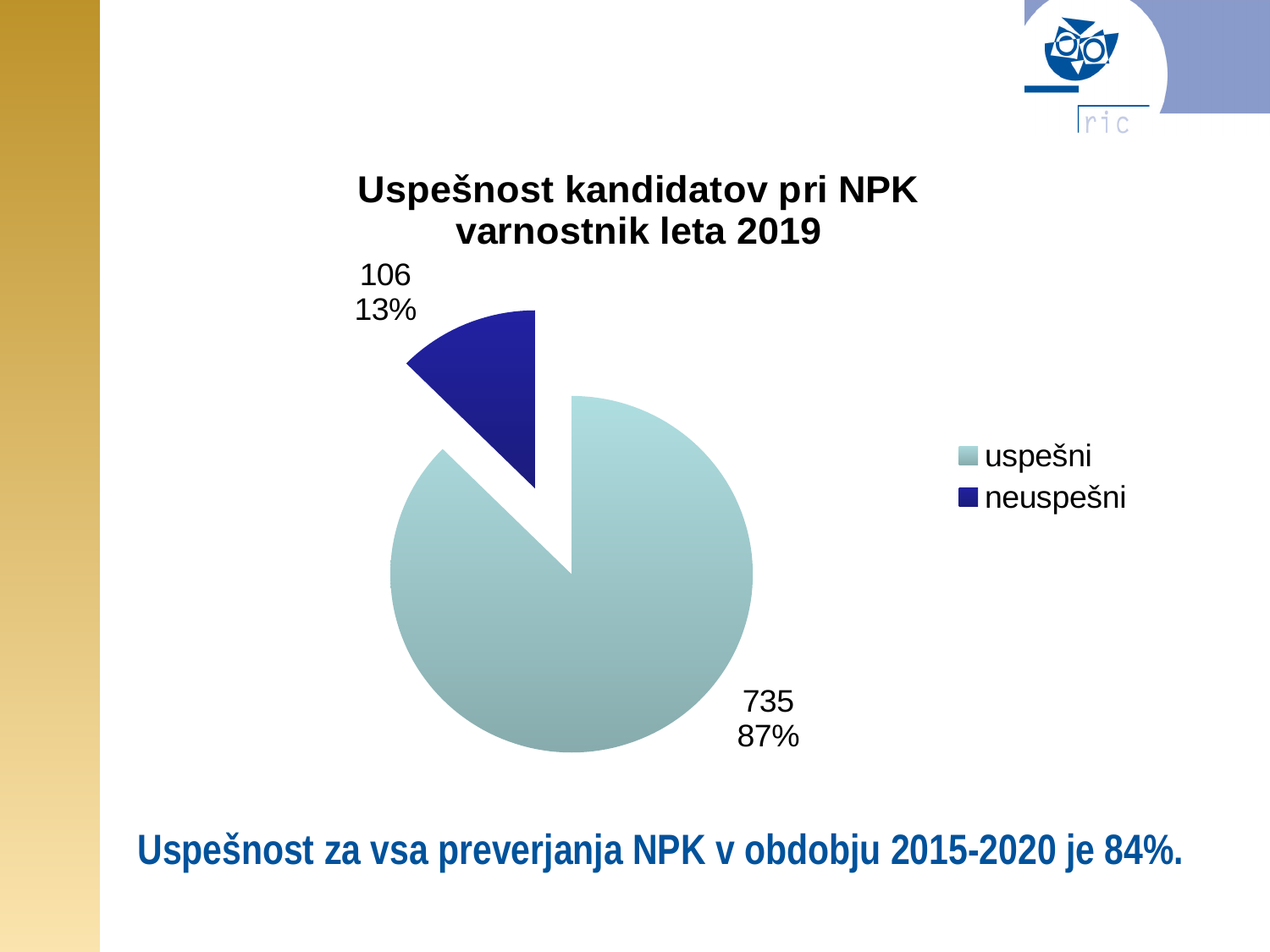
Which category has the largest slice of the pie? uspešni How many candidates were neuspešni according to the chart? 106 What share of the pie does the uspešni slice represent? 87% What is the title of the chart? Uspešnost kandidatov pri NPK varnostnik leta 2019 What is the total number of candidates shown in the pie chart? 841 How many candidates were uspešni according to the chart? 735 How many categories does the legend list? 2 What share of the pie does the neuspešni slice represent? 13% What is the difference between the number of uspešni and neuspešni candidates? 629 Which category has the smallest slice of the pie? neuspešni What kind of chart is shown on the slide? pie chart Which category is larger, uspešni or neuspešni? uspešni